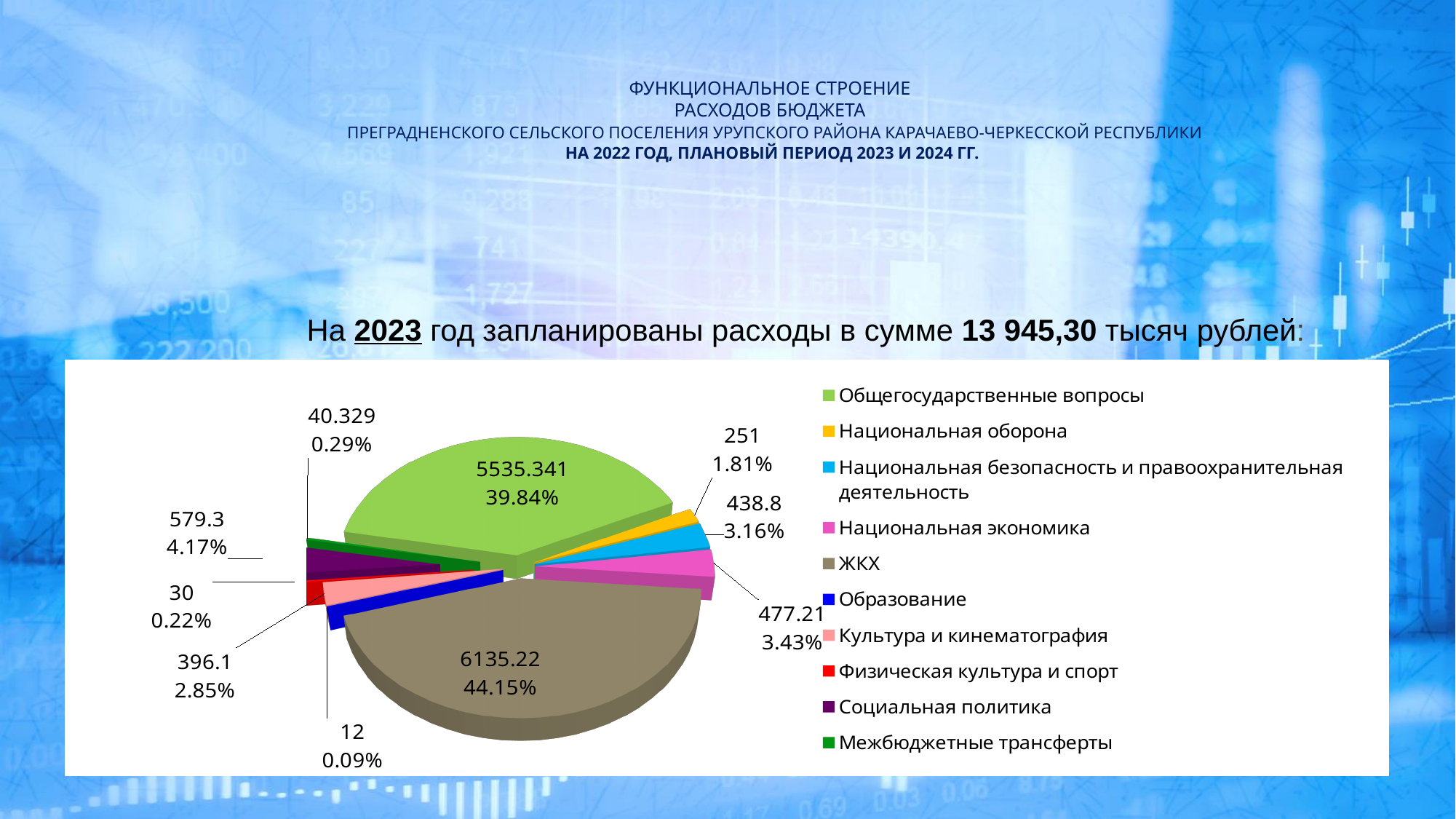
What share of the pie does Общегосударственные вопросы represent? 39.84% What value is shown for Культура и кинематография? 396.1 What type of chart is shown on the slide? pie chart Which category has the smallest slice of the pie? Образование How many categories does the legend of the pie chart list? 10 What colour is the slice for Физическая культура и спорт? red Which category has the largest slice of the pie? ЖКХ What percentage is shown for Национальная экономика? 3.43% What is the value shown for Национальная оборона? 251 What is the value shown for ЖКХ in the pie chart? 6135.22 What is the difference between the values for ЖКХ and Общегосударственные вопросы? 599.879 Which is larger, the value for Социальная политика or the value for Национальная безопасность и правоохранительная деятельность? Социальная политика